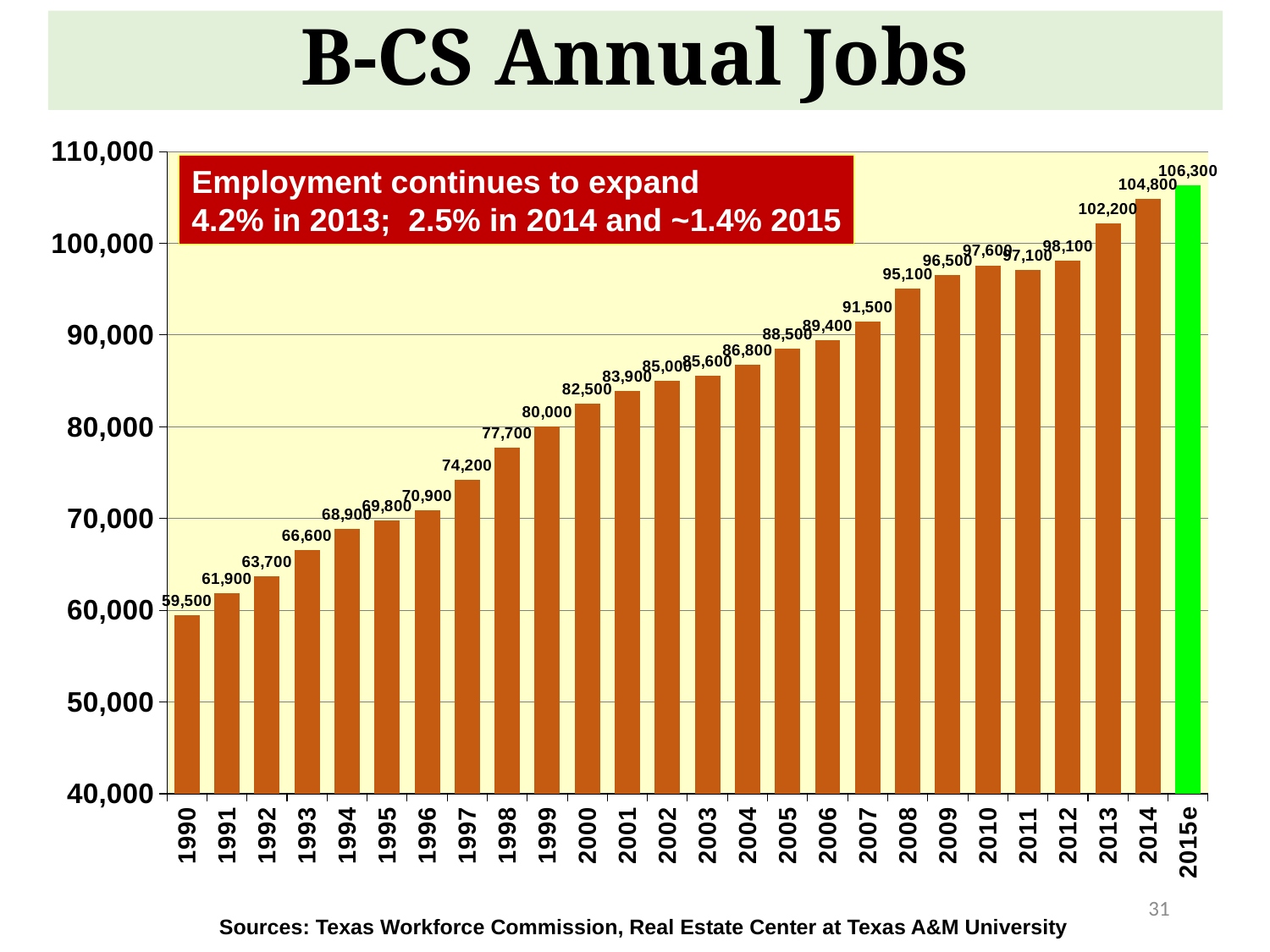
What is the difference between the values for 2014 and 2013? 2,600 What is the value for 1990? 59,500 How many bars are shown in the chart? 26 What is the value for 2013? 102,200 Do the values generally rise or fall from 1990 to 2015e? rise Which year has the highest value? 2015e What is the difference between the values for 2000 and 1990? 23,000 Which is larger, the value for 2010 or the value for 2011? 2010 Is the value for 2008 greater or less than 90,000? greater Which year has the lowest value? 1990 What kind of chart is shown on the slide? bar chart What is the value for 2015e? 106,300